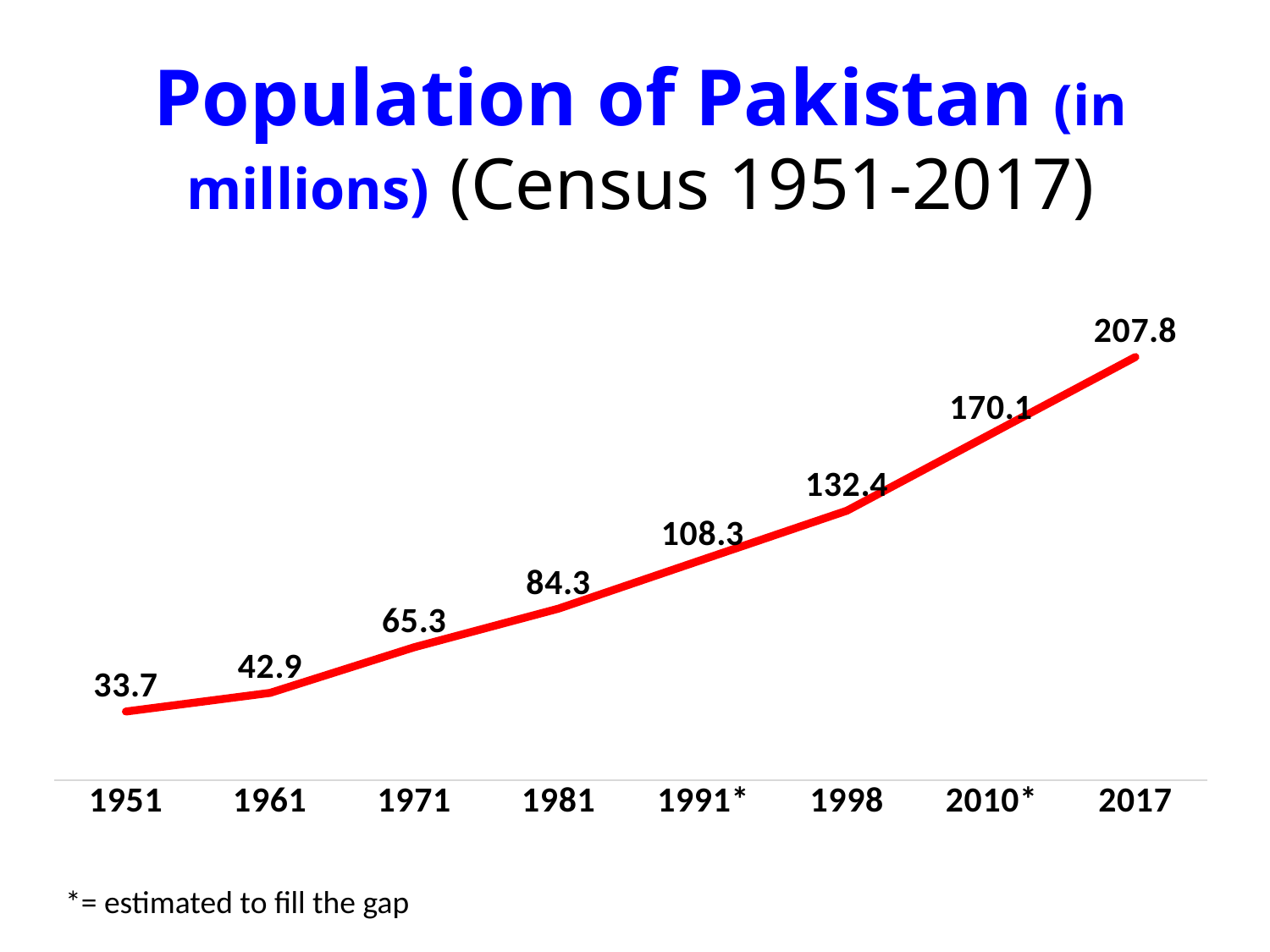
What is the population value shown for 1981? 84.3 What is the population value shown for 2017? 207.8 How many data points are plotted on the chart? 8 What is the population value shown for 1951? 33.7 Which year has the lowest population value on the chart? 1951 Do the population values rise or fall from 1951 to 2017? rise What is the difference between the population values for 1961 and 1951? 9.2 What is the population value shown for 1998? 132.4 What kind of chart is shown on the slide? line chart Which is larger, the value for 1971 or the value for 1991*? 1991* Which year has the highest population value on the chart? 2017 What is the difference between the population values for 2017 and 2010*? 37.7